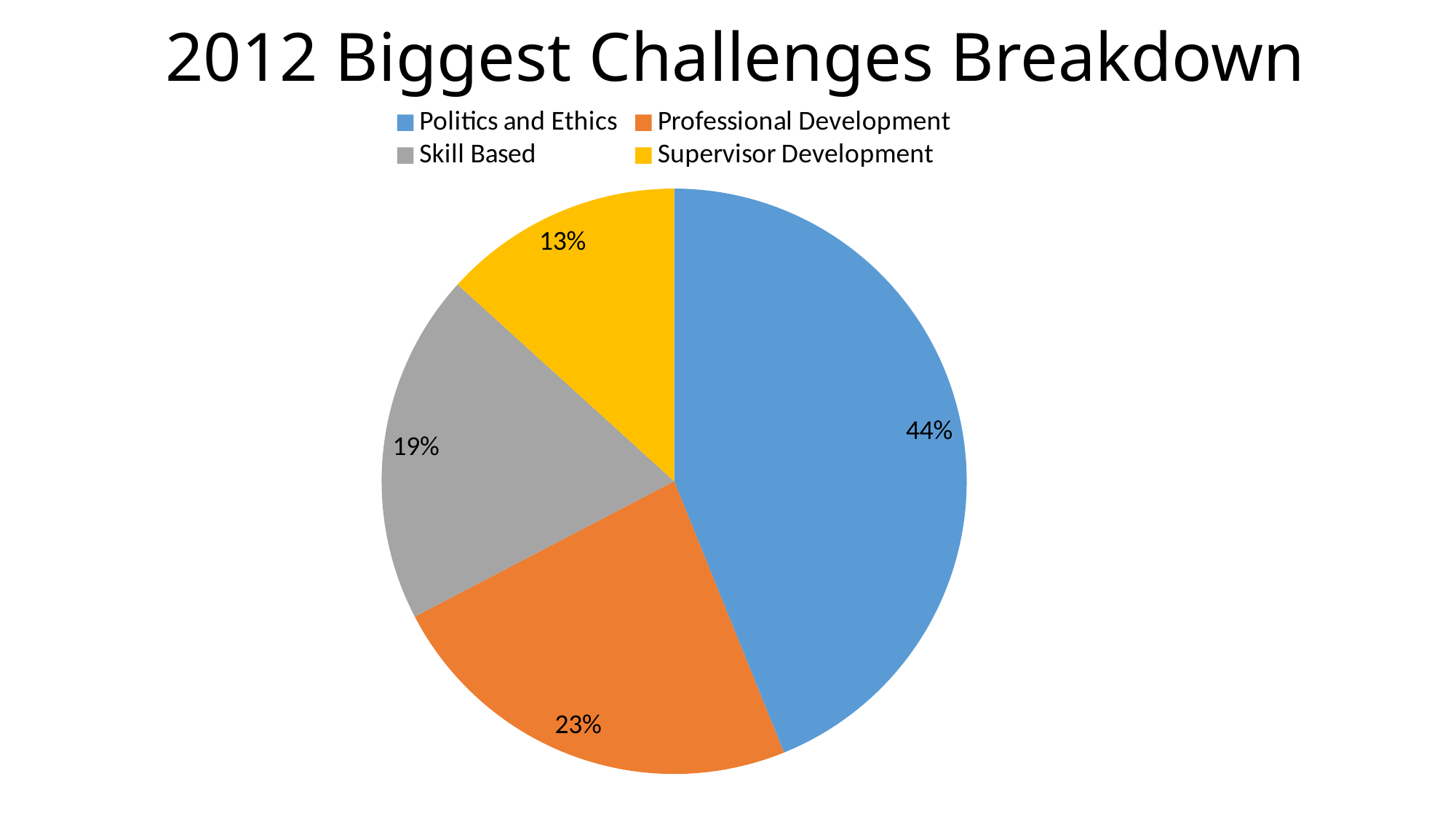
Which is larger, the share for Skill Based or the share for Supervisor Development? Skill Based What is the title of the chart? 2012 Biggest Challenges Breakdown What kind of chart is shown on the slide? pie chart What share of the pie does Professional Development take? 23% Which category has the largest slice of the pie? Politics and Ethics What is the difference in percentage points between Politics and Ethics and Professional Development? 21 What share of the pie does Politics and Ethics take? 44% What share of the pie does Supervisor Development take? 13% Which category has the smallest slice of the pie? Supervisor Development Which colour represents Skill Based in the pie chart? grey How many categories does the pie chart show? 4